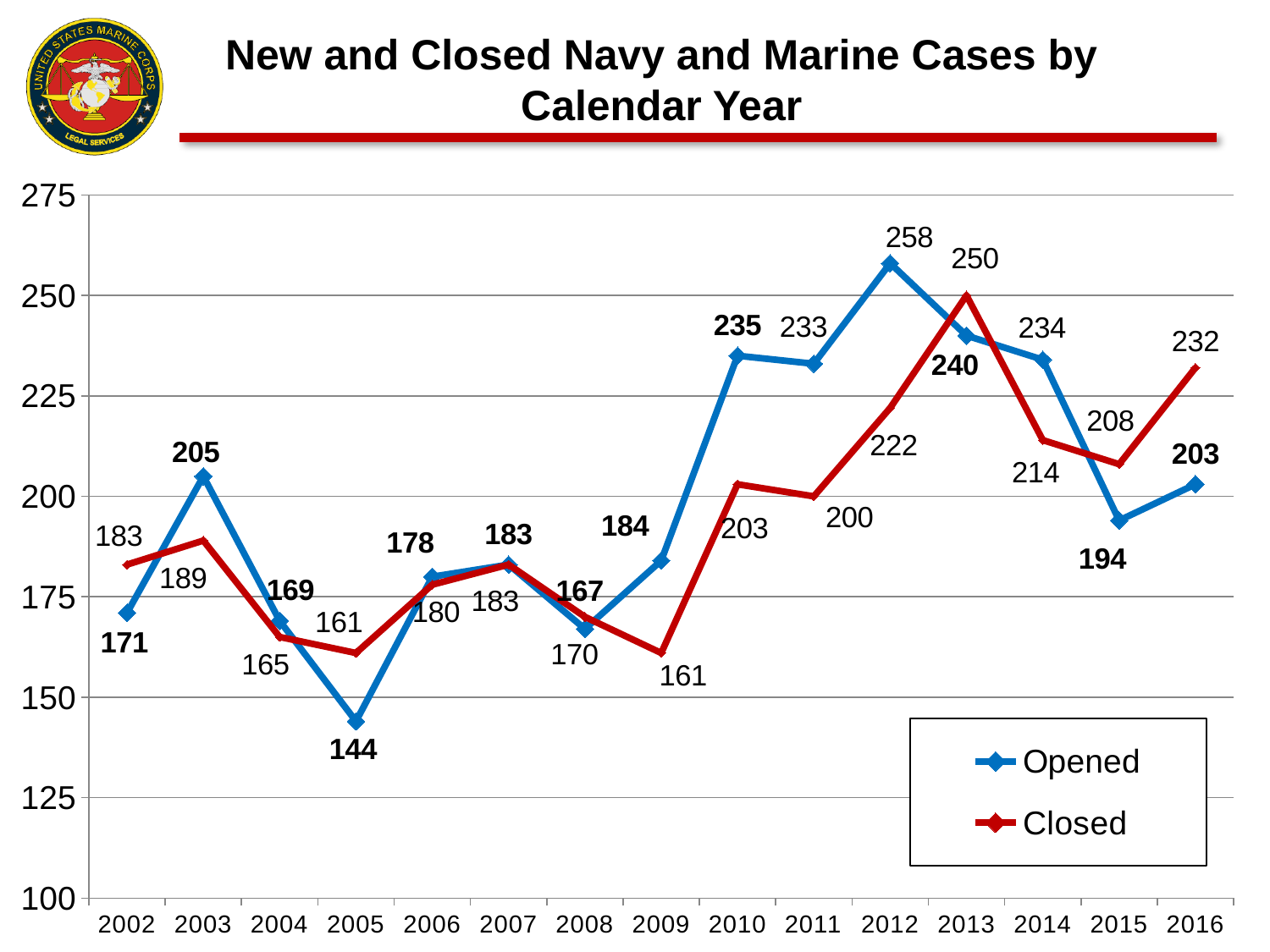
In which year were Opened cases lowest? 2005 How many series does the legend list? 2 What is the value for Opened cases in 2012? 258 Did Opened cases rise or fall from 2012 to 2015? fall How many calendar years are plotted on the x axis? 15 What is the value for Closed cases in 2013? 250 What type of chart is shown on the slide? line chart In which year were Opened cases highest? 2012 What colour is the line for Closed cases? red Which was larger in 2016, Opened or Closed cases? Closed What is the difference between Opened and Closed cases in 2010? 32 What is the value for Opened cases in 2005? 144